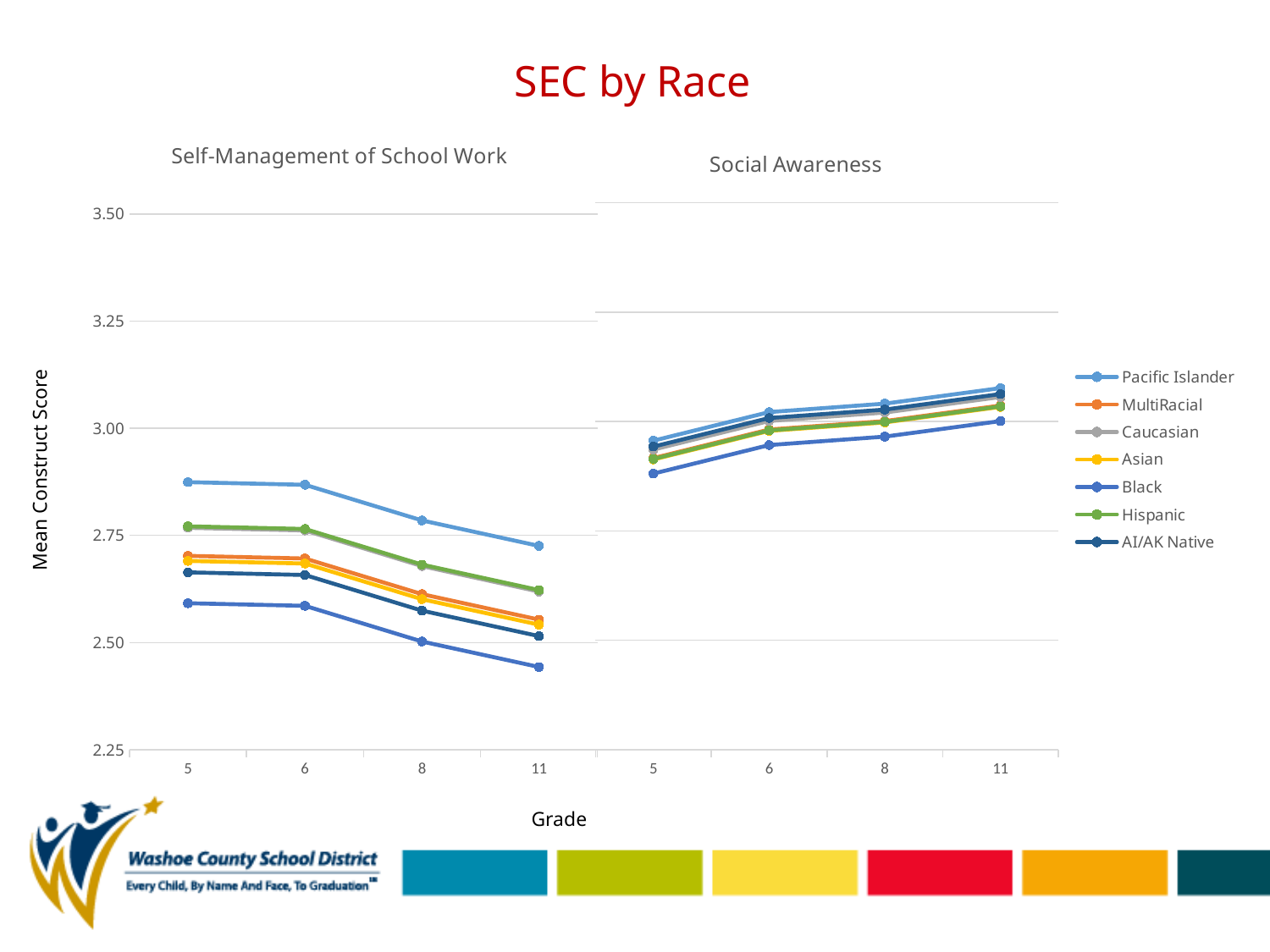
What is the label on the vertical axis shared by the two charts? Mean Construct Score How many grade levels are plotted on the x axis of the Social Awareness chart? 4 In the Self-Management of School Work chart, is the value for Pacific Islander at grade 5 greater or less than 2.75? greater What kind of chart is the Self-Management of School Work chart? line chart In the Self-Management of School Work chart, do the scores rise or fall from grade 5 to grade 11? fall In the Self-Management of School Work chart, which race has the lowest score at grade 11? Black In the Self-Management of School Work chart, which race has the highest score at grade 5? Pacific Islander In the Social Awareness chart, do the scores rise or fall from grade 5 to grade 11? rise How many series does the legend list? 7 In the Social Awareness chart, which is larger at grade 8, the value for Pacific Islander or the value for Black? Pacific Islander In the Social Awareness chart, is the value for Black at grade 5 greater or less than 3.00? less In the Self-Management of School Work chart, is the value for Black at grade 11 greater or less than 2.50? less